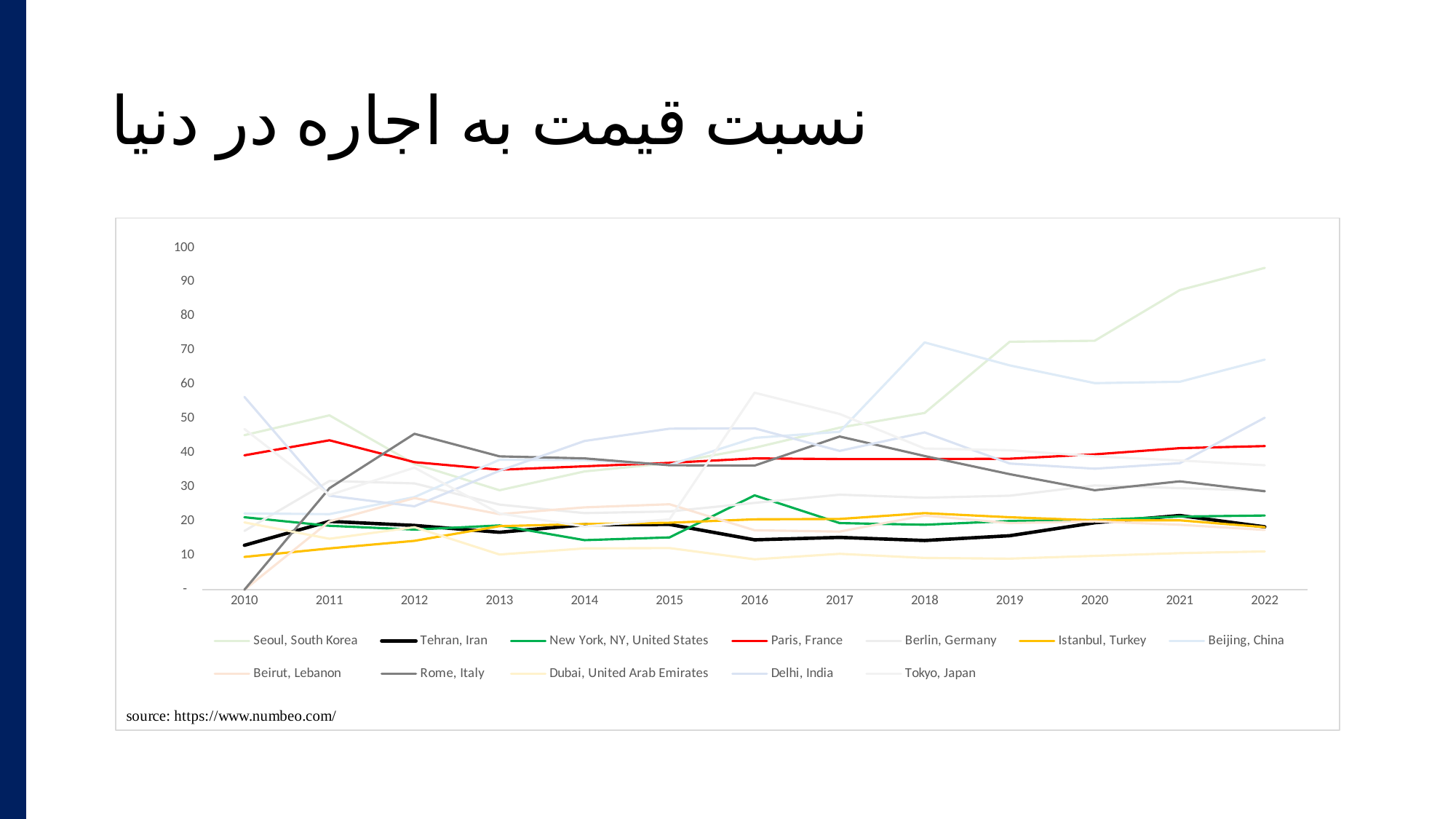
Does the Seoul, South Korea line rise or fall from 2017 to 2022? rise Is the value for Seoul, South Korea in 2022 greater or less than 80? greater In which year does the Seoul, South Korea line reach its highest value? 2022 What kind of chart is shown on the slide? line chart How many years are shown along the x axis? 13 Is the value for Tehran, Iran in 2016 greater or less than 20? less What source is cited below the chart? https://www.numbeo.com/ Is the value for Rome, Italy in 2010 greater or less than 10? less How many series does the legend list? 12 Which city has the highest value in 2022? Seoul, South Korea Which is larger in 2022, the value for Paris, France or the value for Tehran, Iran? Paris, France